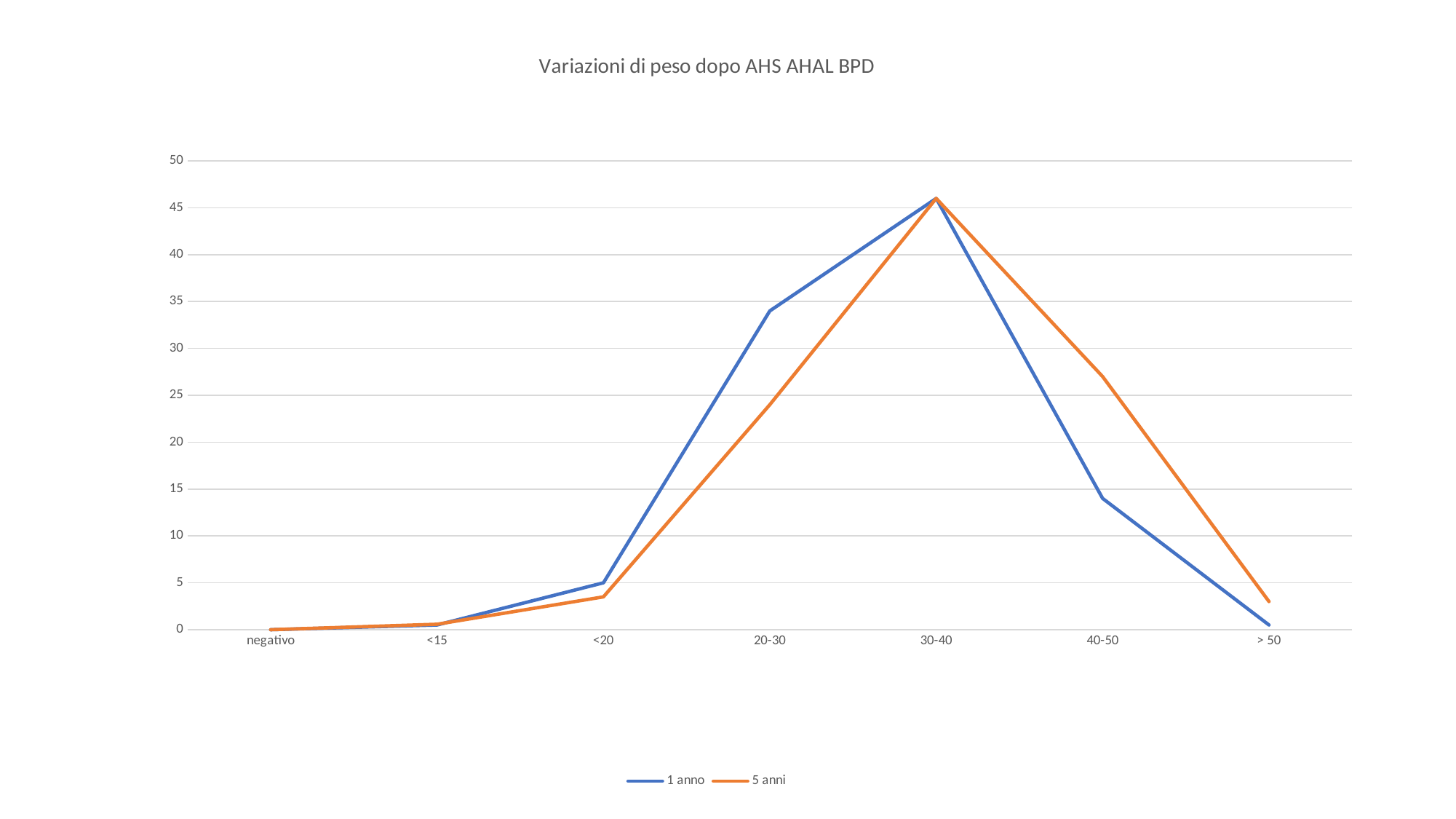
Is the value for 1 anno at 20-30 greater or less than 30? greater What is the title of the chart? Variazioni di peso dopo AHS AHAL BPD At 40-50, which series has the larger value, 1 anno or 5 anni? 5 anni Which series is drawn in orange? 5 anni Is the value for 5 anni at > 50 greater or less than 5? less For which category does the 1 anno series reach its highest value? 30-40 Does the 1 anno series rise or fall from 30-40 to > 50? fall At 20-30, which series has the larger value, 1 anno or 5 anni? 1 anno How many series does the legend list? 2 What kind of chart is shown on the slide? line chart For which category does the 5 anni series reach its highest value? 30-40 How many categories are shown on the x axis? 7